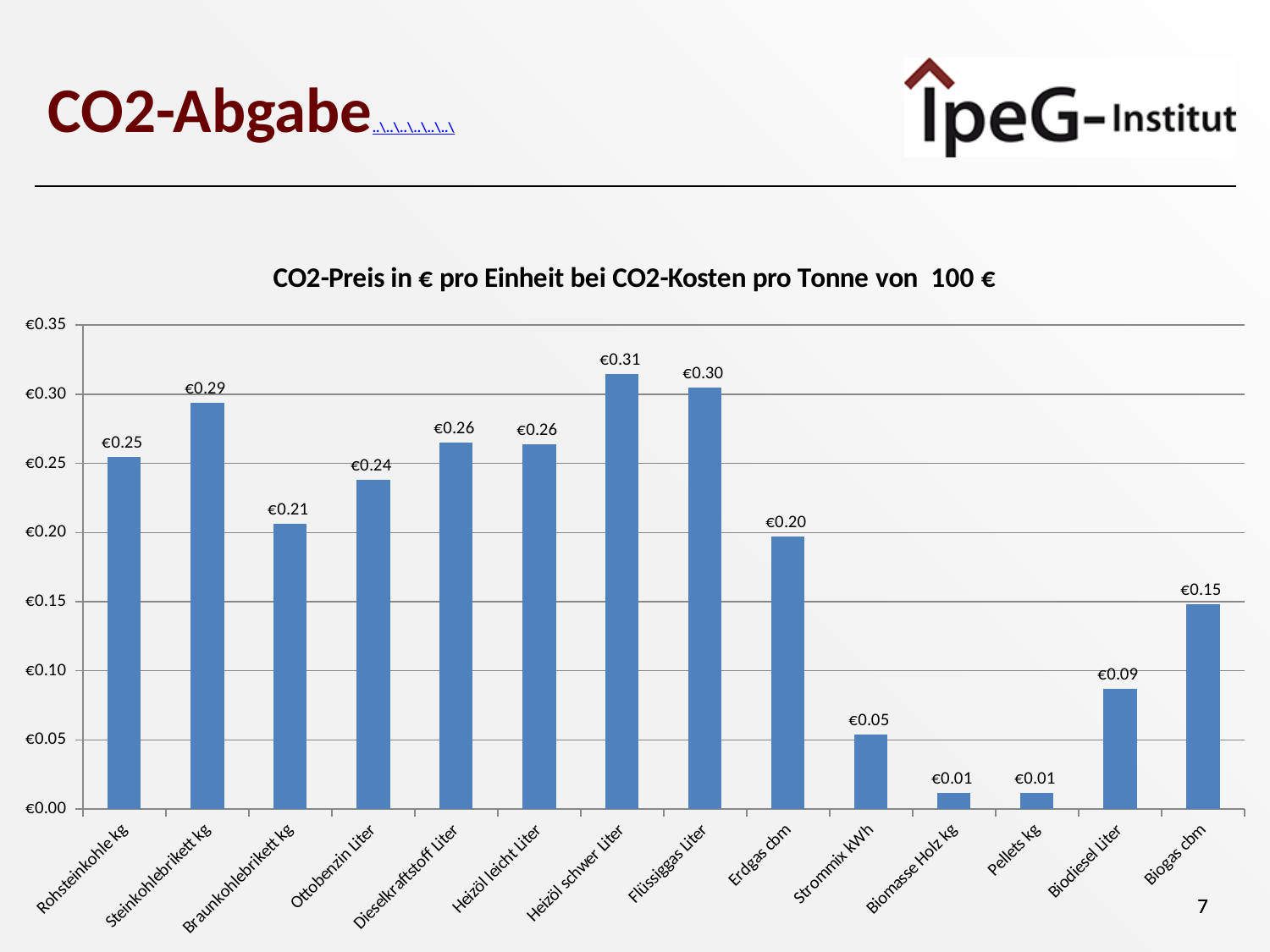
How many categories are shown on the x axis of the chart? 14 What is the value shown for Biogas cbm? €0.15 What is the difference between the values for Steinkohlebrikett kg and Braunkohlebrikett kg? €0.08 What kind of chart is shown on the slide? bar chart What is the title of the chart? CO2-Preis in € pro Einheit bei CO2-Kosten pro Tonne von 100 € What is the value shown for Strommix kWh? €0.05 What is the difference between the values for Heizöl schwer Liter and Erdgas cbm? €0.11 Is the value for Biodiesel Liter greater or less than €0.10? less Which is larger, the value for Flüssiggas Liter or the value for Rohsteinkohle kg? Flüssiggas Liter Which category has the highest CO2 price in the chart? Heizöl schwer Liter What is the CO2 price shown for Heizöl schwer Liter? €0.31 What is the value shown for Erdgas cbm? €0.20